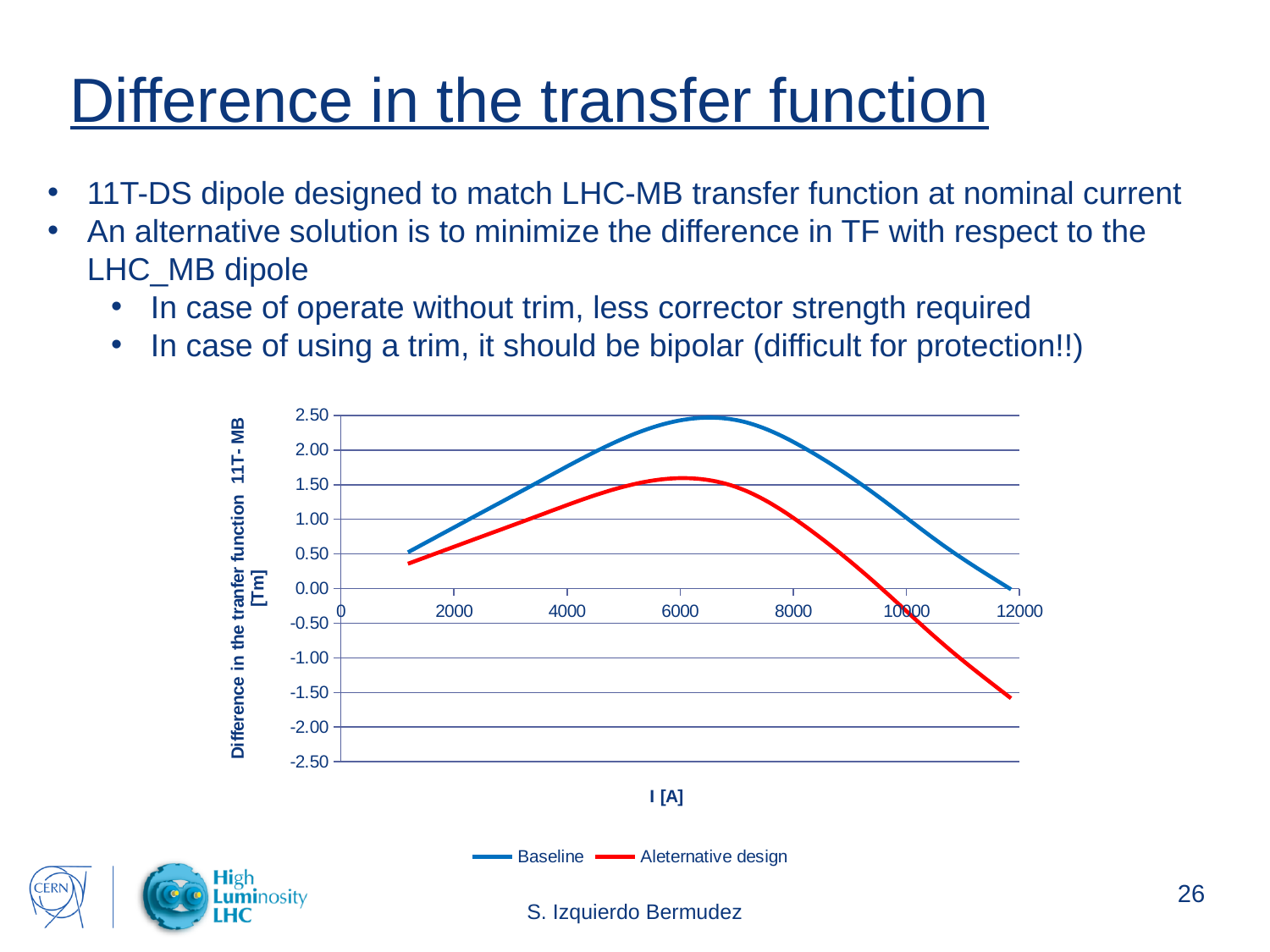
Is the Aleternative design value at I = 12000 A greater or less than -1.00? less Is the Aleternative design value at I = 6000 A greater or less than 1.00? greater Is the Aleternative design value at I = 10000 A greater or less than 0.50? less What are the two series named in the chart legend? Baseline and Aleternative design How many series does the chart legend list? 2 Which series reaches the higher peak value on the chart? Baseline At I = 6000 A, which series has the larger value, Baseline or Aleternative design? Baseline What is the label of the x axis of the chart? I [A] What kind of chart is shown on the slide? line chart How does the Aleternative design curve behave as I increases from 0 to 12000 A? rises to a peak near 6000 A, then falls